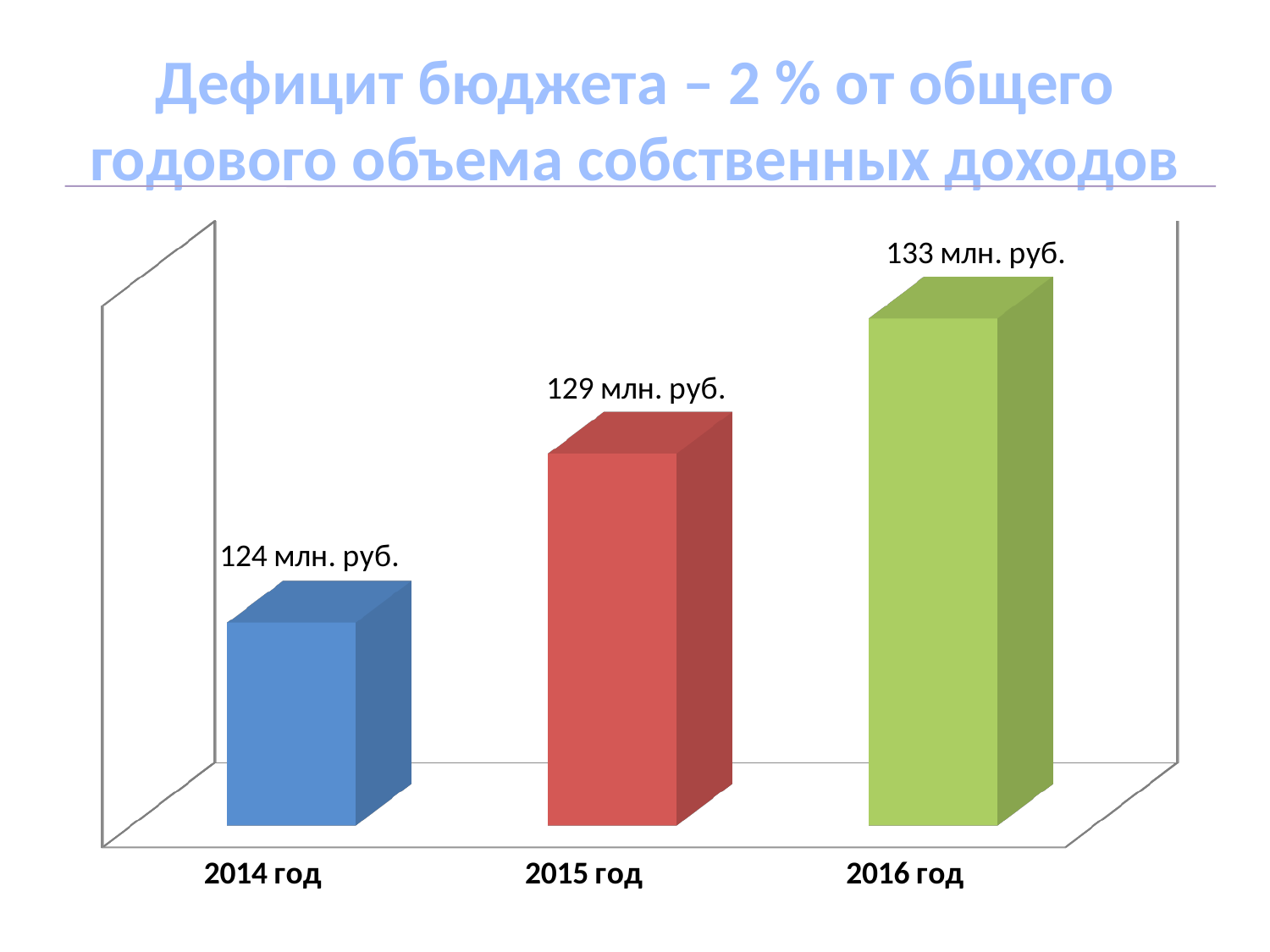
What is the difference between the values for 2016 год and 2014 год? 9 млн. руб. Which year has the highest value? 2016 год What is the difference between the values for 2015 год and 2014 год? 5 млн. руб. Which is larger, the value for 2015 год or the value for 2016 год? 2016 год What colour is the bar for 2015 год? red What kind of chart is shown on the slide? bar chart How many categories are shown on the chart? 3 Which year has the lowest value? 2014 год Do the values rise or fall from 2014 год to 2016 год? rise What is the value for 2016 год? 133 млн. руб. What is the value for 2015 год? 129 млн. руб. What is the value for 2014 год? 124 млн. руб.